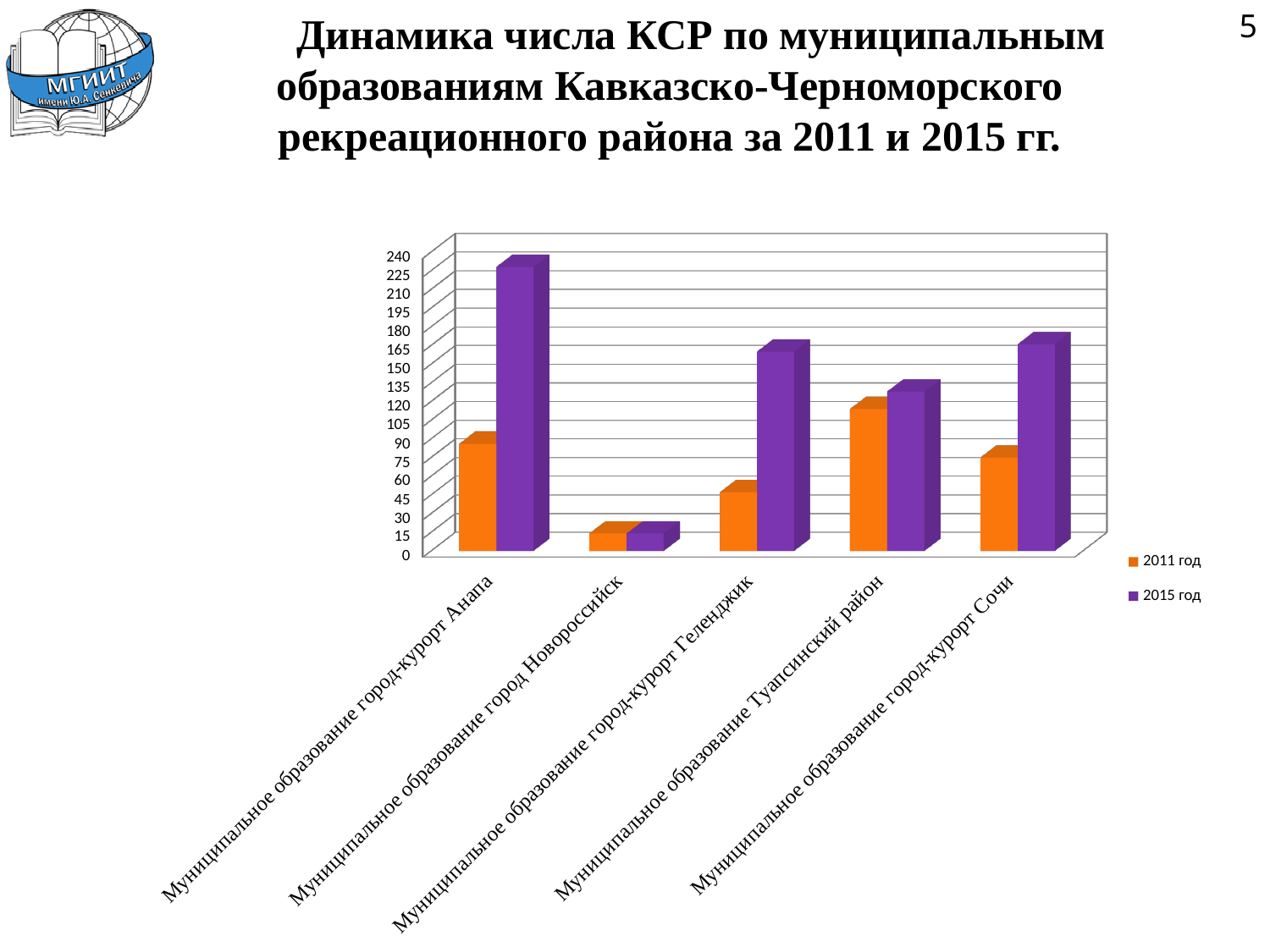
Which municipal entity has the highest value for 2011 год? Муниципальное образование Туапсинский район How many series does the legend list? 2 What colour are the bars for the 2015 год series? purple What kind of chart is shown on the slide? bar chart How many municipal entities (categories) are shown on the x axis? 5 Which municipal entity has the lowest value for 2015 год? Муниципальное образование город Новороссийск Is the 2011 год value for Муниципальное образование город-курорт Геленджик greater or less than 60? less Is the 2011 год value for Муниципальное образование Туапсинский район greater or less than 90? greater Which municipal entity has the highest value for 2015 год? Муниципальное образование город-курорт Анапа Which is larger: the 2011 год value for Муниципальное образование Туапсинский район or the 2011 год value for Муниципальное образование город-курорт Анапа? Муниципальное образование Туапсинский район Is the 2015 год value for Муниципальное образование город-курорт Анапа greater or less than 210? greater